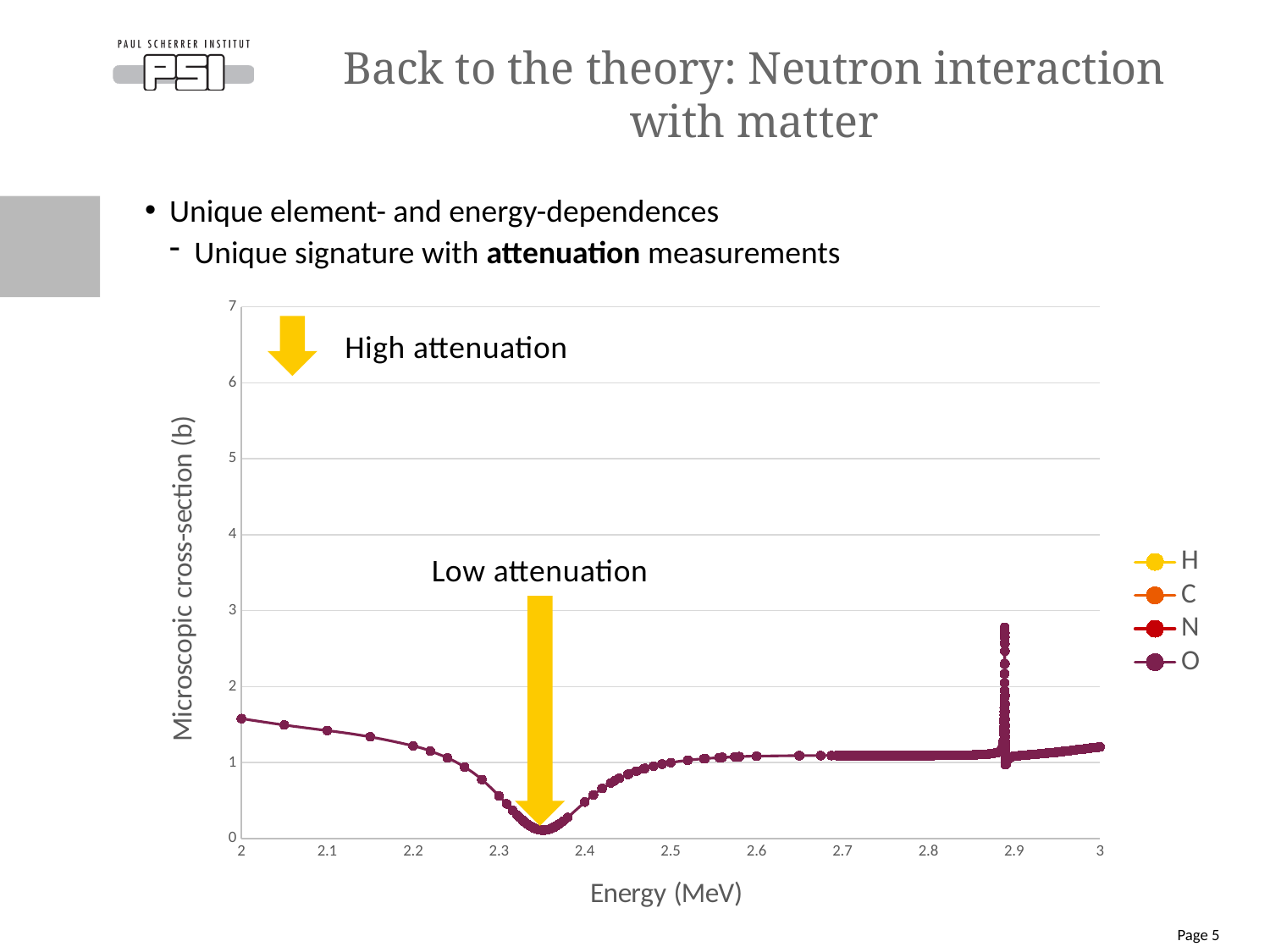
Is the value of the O curve at 2.6 MeV greater or less than 2? less What are the series names listed in the chart legend? H, C, N, O Is the value of the O curve at 2 MeV greater or less than 1? greater Do the values of the O curve rise or fall between 2.4 MeV and 2.5 MeV? rise How many series does the chart legend list? 4 What is the label of the x axis of the chart? Energy (MeV) Do the values of the O curve rise or fall between 2 MeV and 2.3 MeV? fall Which is larger for the O curve: the value at 2.2 MeV or the value at 2.5 MeV? the value at 2.2 MeV Is the peak of the O curve near 2.9 MeV greater or less than 2? greater What kind of chart is shown on the slide? line chart Which is larger for the O curve: the value at 2 MeV or the value at 2.35 MeV? the value at 2 MeV